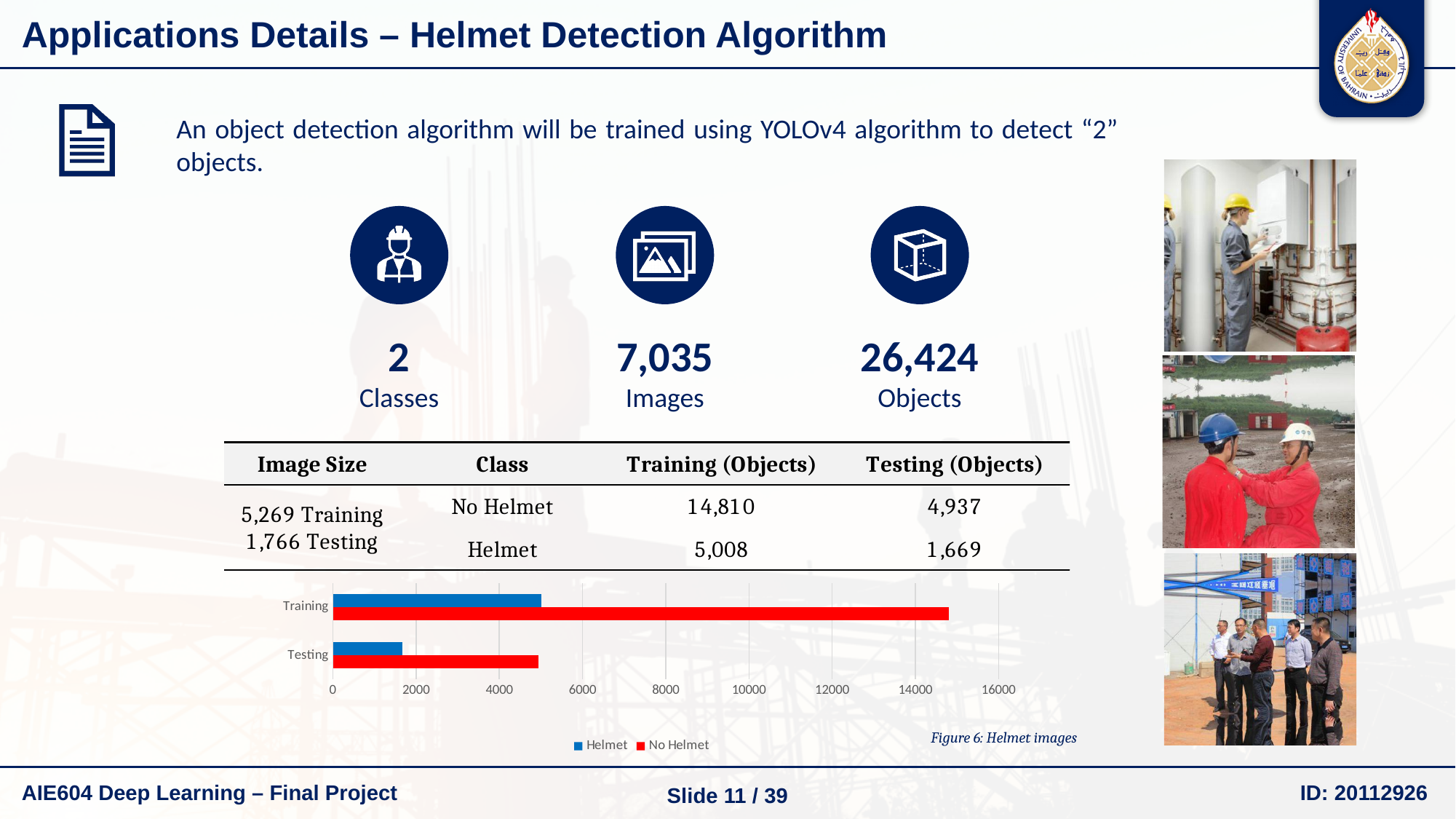
What kind of chart is shown at the bottom of the slide? bar chart How many series does the legend of the bar chart list? 2 Which bar is the shortest in the whole chart? Helmet for Testing What is the No Helmet value for Training in the bar chart? 14,810 What colour represents the No Helmet series in the bar chart? red Which category has the longer No Helmet bar, Training or Testing? Training Is the Helmet value for Testing greater or less than 2000? less Is the No Helmet value for Training greater or less than 14000? greater How many categories are shown on the vertical axis of the bar chart? 2 What is the difference between the No Helmet and Helmet values for Training? 9,802 What is the Helmet value for Testing in the bar chart? 1,669 In the Training category, which is larger, Helmet or No Helmet? No Helmet